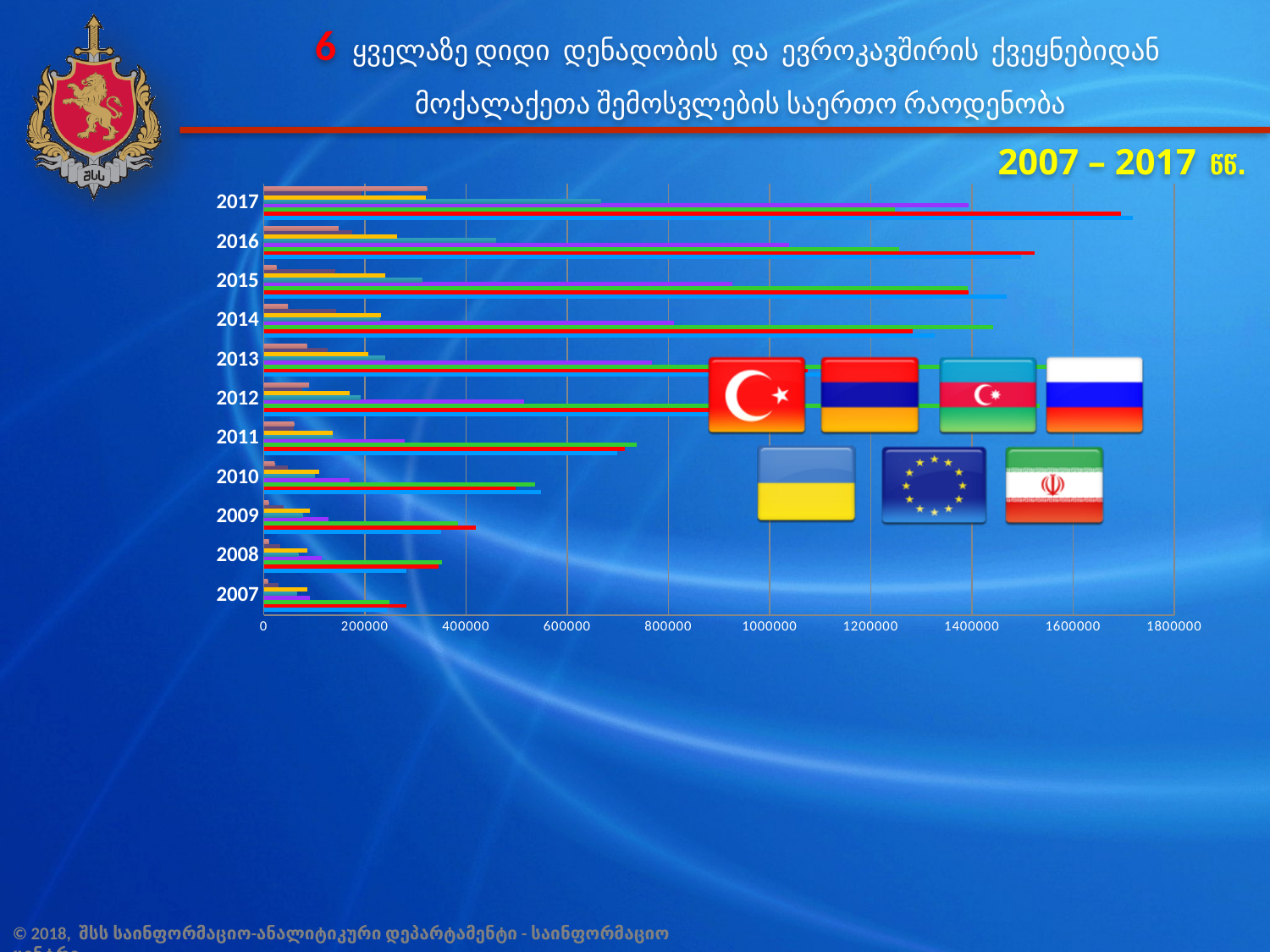
Which year has the longest bar in the chart? 2017 How many years are listed on the vertical axis of the chart? 11 Is the longest bar for 2017 greater or less than 1600000? greater Is the longest bar for 2017 larger than the longest bar for 2010? yes Is the longest bar for 2016 greater or less than 1400000? greater Do the longest bars generally rise or fall from 2007 to 2017? rise Which year has the shortest longest-bar in the chart? 2007 What kind of chart is shown on the slide? bar chart Is the longest bar for 2013 greater or less than 1200000? greater What is the highest value shown on the horizontal axis of the chart? 1800000